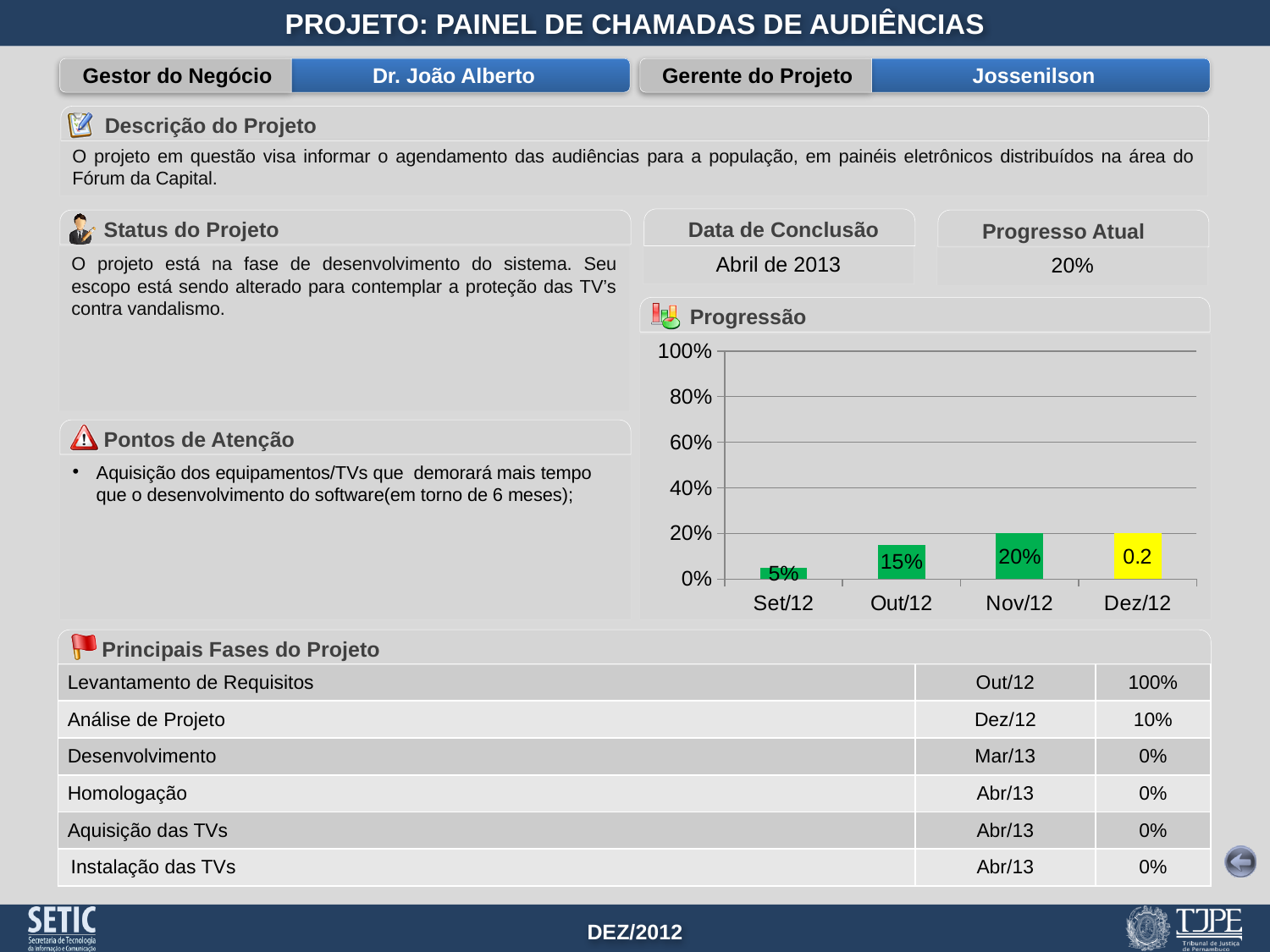
What is the value shown for Nov/12 in the Progressão chart? 20% What data label is printed on the Dez/12 bar in the Progressão chart? 0.2 What is the value shown for Set/12 in the Progressão chart? 5% What is the difference between the values for Nov/12 and Out/12 in the Progressão chart? 5% What colour is the Dez/12 bar in the Progressão chart? yellow What is the difference between the values for Out/12 and Set/12 in the Progressão chart? 10% In the Progressão chart, is the value for Nov/12 greater or less than 40%? less How many months are shown on the x axis of the Progressão chart? 4 What is the value shown for Out/12 in the Progressão chart? 15% What kind of chart is the Progressão chart? bar chart In the Progressão chart, which is larger: the value for Out/12 or the value for Set/12? Out/12 Which month has the lowest value in the Progressão chart? Set/12